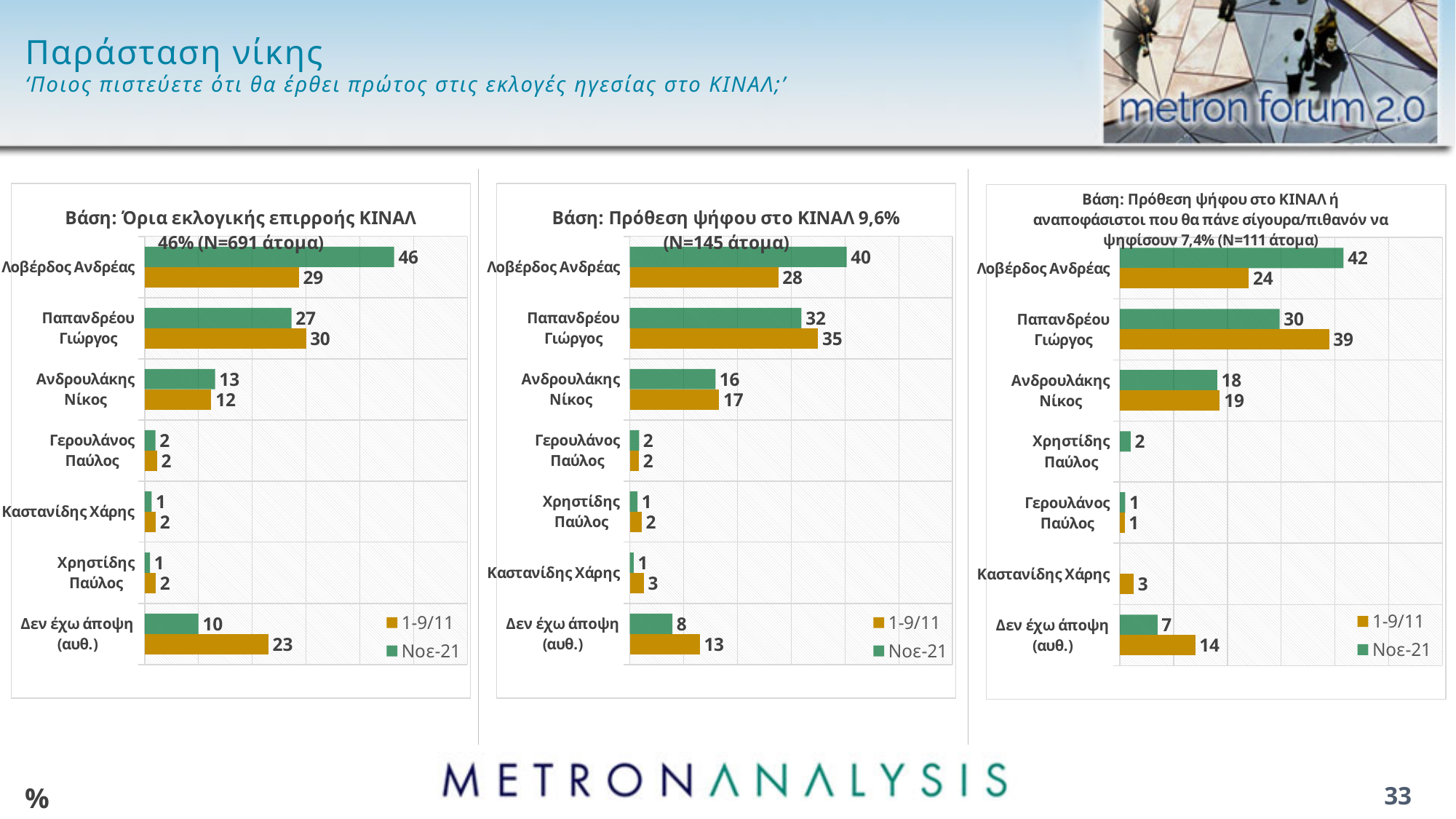
How many categories are shown in the middle chart (Βάση: Πρόθεση ψήφου στο ΚΙΝΑΛ 9,6%)? 7 In the right chart (Βάση: Πρόθεση ψήφου στο ΚΙΝΑΛ ή αναποφάσιστοι), what is the 1-9/11 value for Παπανδρέου Γιώργος? 39 In the left chart (Βάση: Όρια εκλογικής επιρροής ΚΙΝΑΛ), what is the 1-9/11 value for Δεν έχω άποψη (αυθ.)? 23 In the right chart (Βάση: Πρόθεση ψήφου στο ΚΙΝΑΛ ή αναποφάσιστοι), what is the Νοε-21 value for Λοβέρδος Ανδρέας? 42 In the middle chart (Βάση: Πρόθεση ψήφου στο ΚΙΝΑΛ 9,6%), which candidate has the highest Νοε-21 value? Λοβέρδος Ανδρέας In the left chart (Βάση: Όρια εκλογικής επιρροής ΚΙΝΑΛ), what is the Νοε-21 value for Λοβέρδος Ανδρέας? 46 In the left chart (Βάση: Όρια εκλογικής επιρροής ΚΙΝΑΛ), what is the difference between the Νοε-21 and 1-9/11 values for Λοβέρδος Ανδρέας? 17 In the right chart (Βάση: Πρόθεση ψήφου στο ΚΙΝΑΛ ή αναποφάσιστοι), what is the difference between the 1-9/11 and Νοε-21 values for Δεν έχω άποψη (αυθ.)? 7 In the middle chart (Βάση: Πρόθεση ψήφου στο ΚΙΝΑΛ 9,6%), what is the 1-9/11 value for Παπανδρέου Γιώργος? 35 How many series does the legend list in the left chart (Βάση: Όρια εκλογικής επιρροής ΚΙΝΑΛ)? 2 In the middle chart (Βάση: Πρόθεση ψήφου στο ΚΙΝΑΛ 9,6%), which is larger for Ανδρουλάκης Νίκος: the 1-9/11 value or the Νοε-21 value? 1-9/11 What kind of chart is the right chart (Βάση: Πρόθεση ψήφου στο ΚΙΝΑΛ ή αναποφάσιστοι)? Bar chart